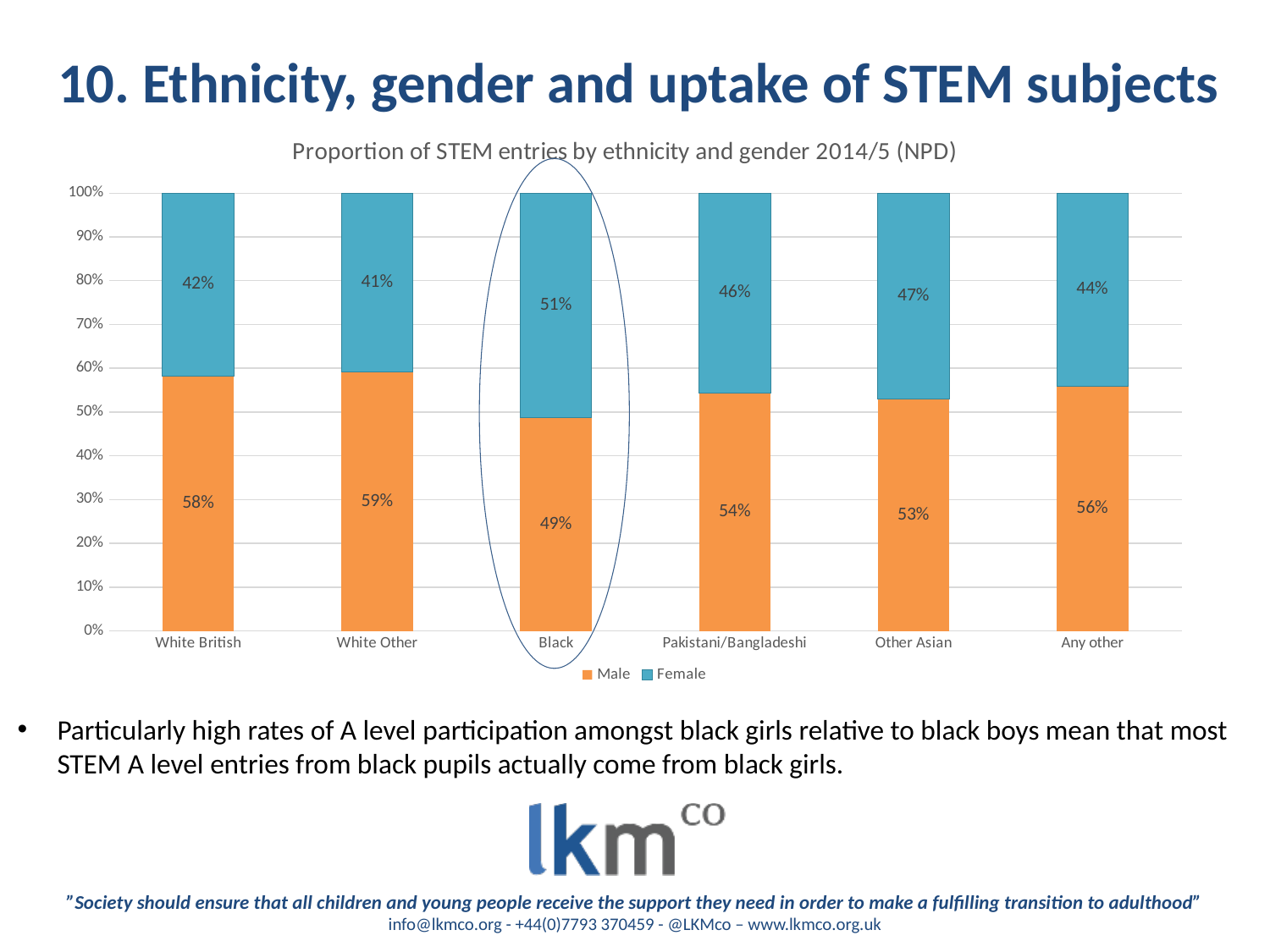
What is the Male value for White British? 58% Which is larger, the Male value for White British or the Male value for Any other? White British Which ethnicity has the highest Male share? White Other How many series does the legend list? 2 Which ethnicity has the lowest Male share? Black How many ethnicity categories are shown on the x axis? 6 What type of chart is shown? Stacked bar chart Which ethnicity has the highest Female share? Black What is the Male value for Pakistani/Bangladeshi? 54% What is the Female value for Any other? 44% What is the Female value for Black? 51% What is the difference between the Male and Female values for Other Asian? 6%